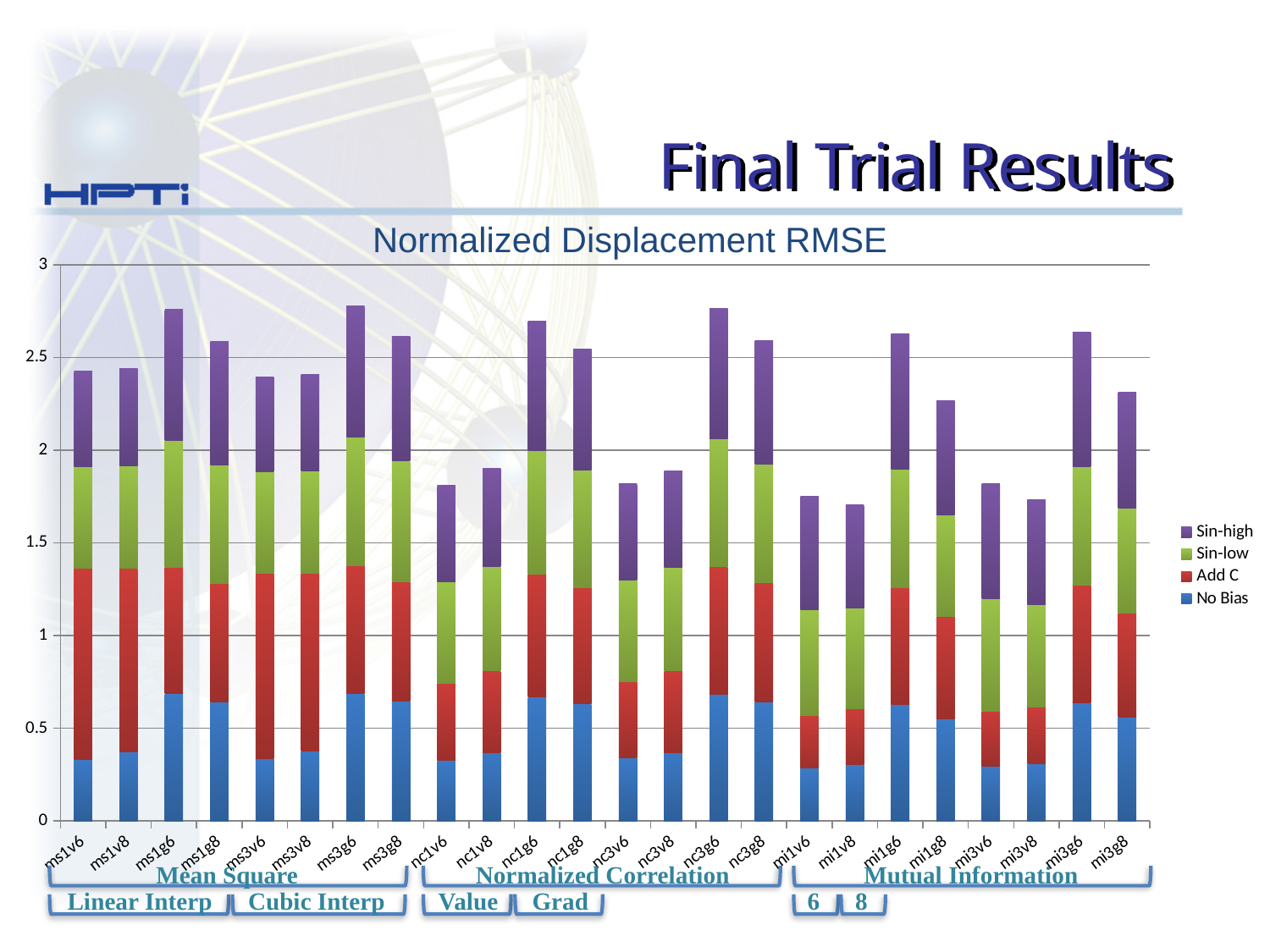
Is the total stacked value for nc3v6 greater or less than 2? less What is the title of the chart? Normalized Displacement RMSE Which has the larger total stacked value, nc3g6 or nc3v6? nc3g6 How many categories are plotted along the x axis? 24 How many series does the legend list? 4 Is the total stacked value for mi1g6 greater or less than 2.5? greater What kind of chart is shown on the slide? stacked bar chart Which has the larger total stacked value, ms1g6 or ms1v6? ms1g6 Is the total stacked value for mi1v8 greater or less than 2? less Which series is shown at the bottom of each stacked bar? No Bias Which has the larger total stacked value, mi1g8 or mi3g6? mi3g6